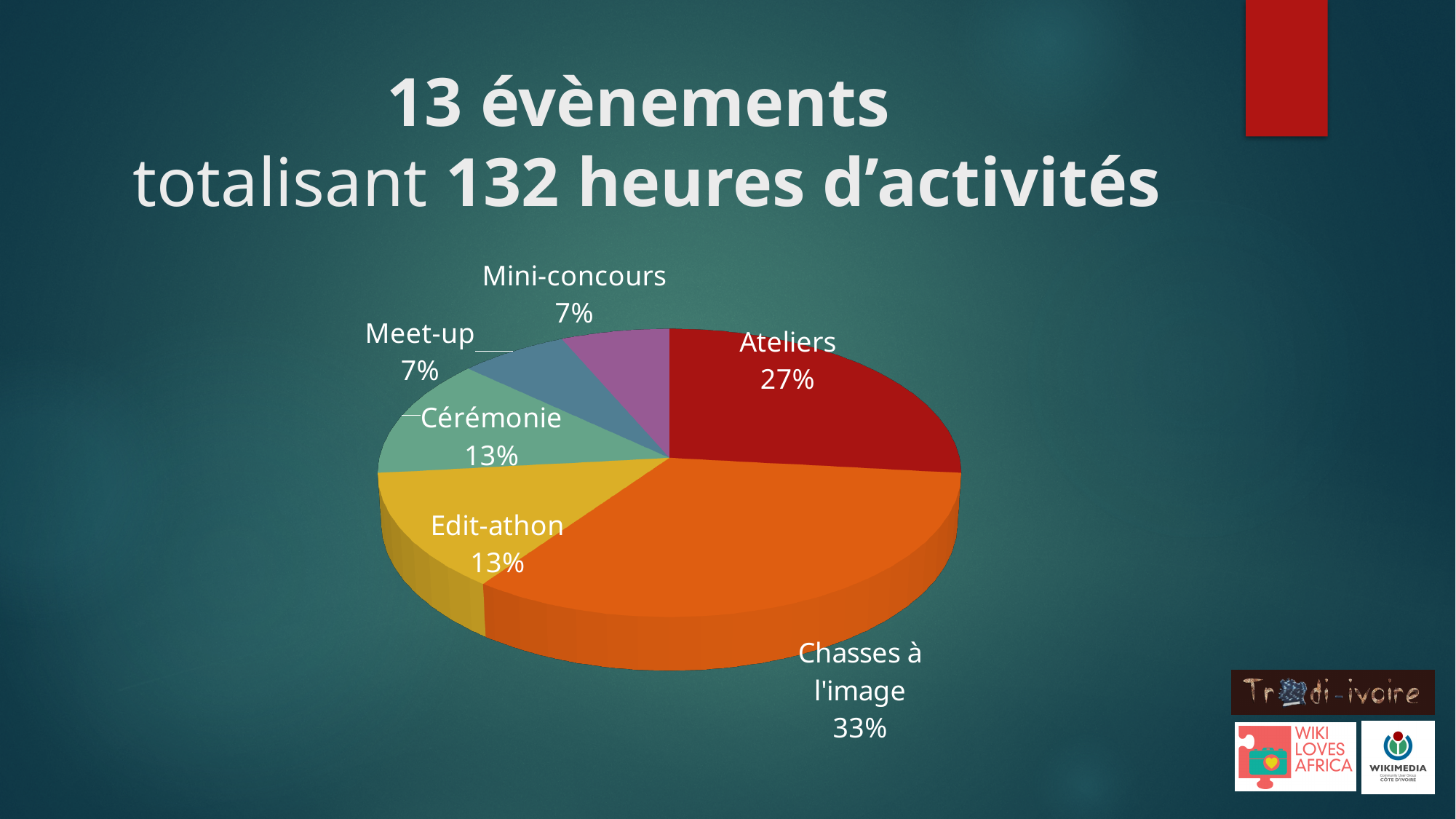
What percentage is shown for Meet-up? 7% What is the difference in percentage points between Chasses à l'image and Ateliers? 6 How many categories are shown in the pie chart? 6 According to the slide title, how many hours of activities do the 13 events total? 132 heures What kind of chart is shown on the slide? Pie chart Which is larger, the share for Ateliers or the share for Edit-athon? Ateliers Which category has the largest slice of the pie? Chasses à l'image What percentage is shown for Cérémonie? 13% What share of the pie does Ateliers represent? 27% What share of the pie does Chasses à l'image represent? 33% What colour is the Chasses à l'image slice? Orange What is the combined share of Edit-athon and Cérémonie? 26%